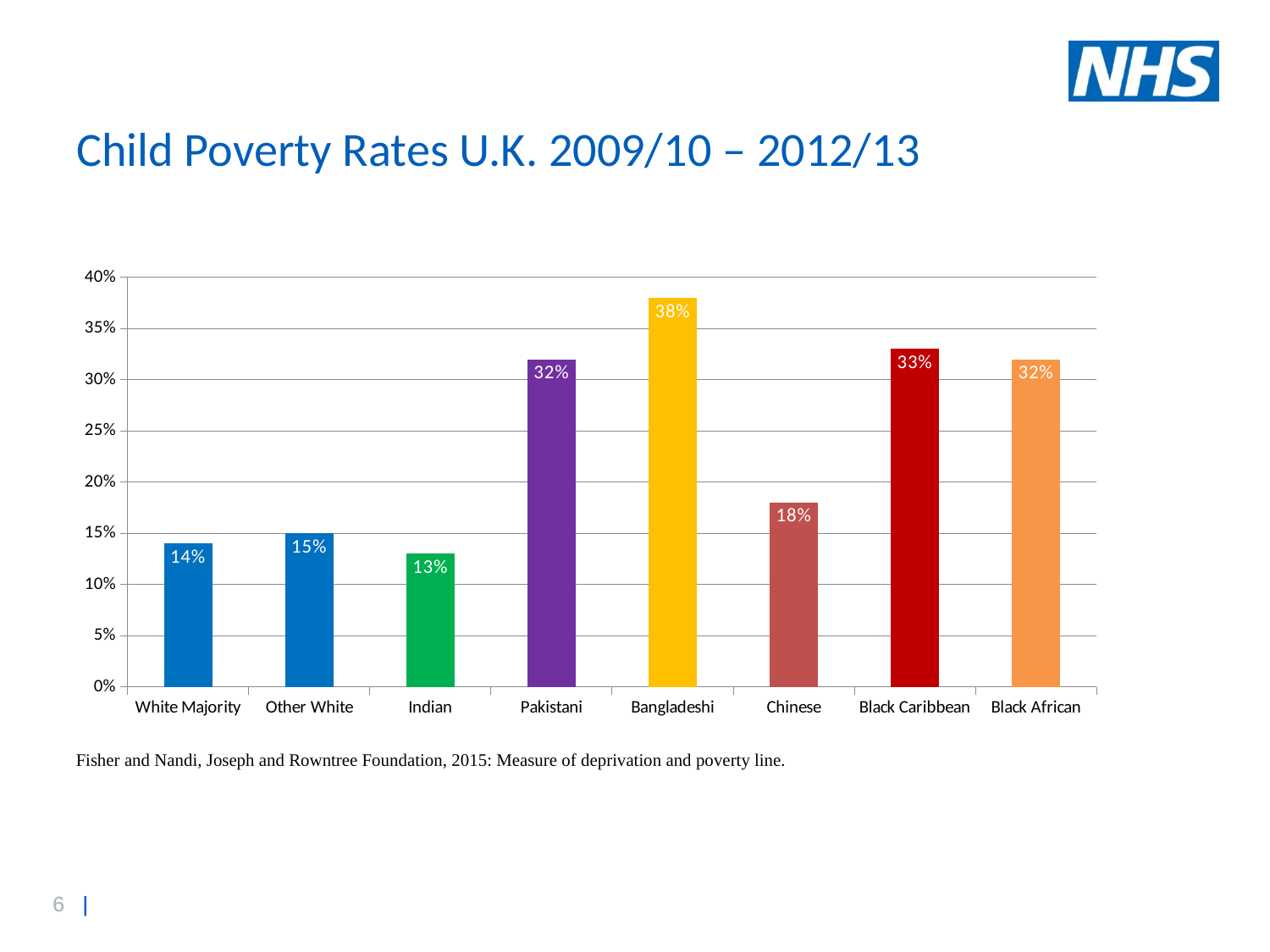
What type of chart is shown on the slide? Bar chart Which has a higher child poverty rate, Pakistani or Chinese? Pakistani What is the title of the chart on the slide? Child Poverty Rates U.K. 2009/10 – 2012/13 What is the difference between the child poverty rates for Bangladeshi and Indian children? 25% How many ethnic groups are shown on the chart? 8 What is the child poverty rate for Bangladeshi children? 38% Which group has the lowest child poverty rate? Indian Which group has the highest child poverty rate? Bangladeshi Is the child poverty rate for Black African children greater or less than 20%? greater What is the child poverty rate for the Chinese group? 18% What is the difference between the child poverty rates for Black Caribbean and Chinese children? 15% What is the child poverty rate for the White Majority group? 14%